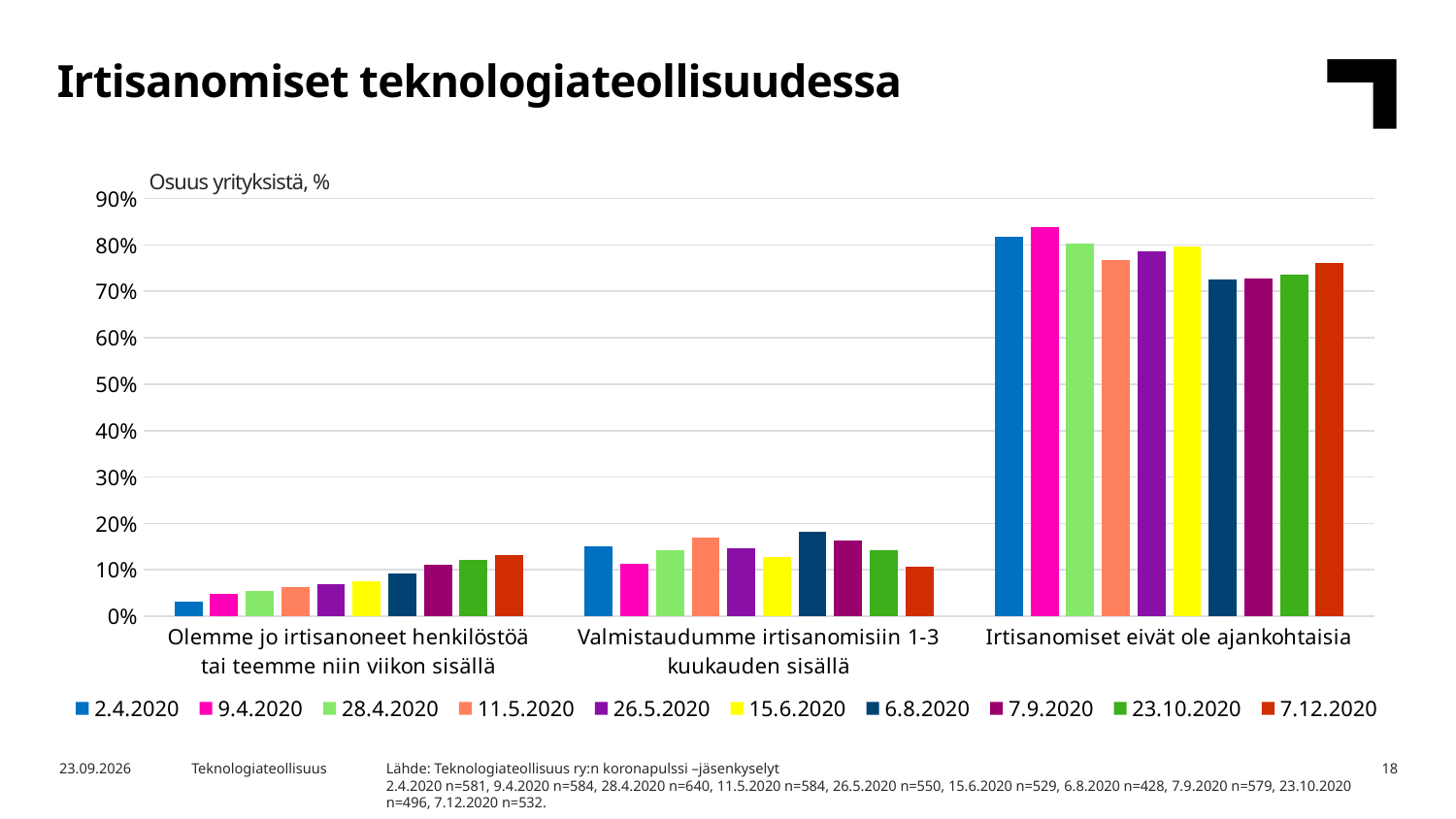
Is the value for 2.4.2020 in the category "Olemme jo irtisanoneet henkilöstöä tai teemme niin viikon sisällä" greater or less than 10%? less What kind of chart is shown on the slide? Bar chart Which survey date has the lowest value in the category "Olemme jo irtisanoneet henkilöstöä tai teemme niin viikon sisällä"? 2.4.2020 In the category "Olemme jo irtisanoneet henkilöstöä tai teemme niin viikon sisällä", do the values rise or fall from 2.4.2020 to 7.12.2020? rise Which survey date has the highest value in the category "Irtisanomiset eivät ole ajankohtaisia"? 9.4.2020 How many series does the legend list? 10 Is the value for 6.8.2020 in the category "Irtisanomiset eivät ole ajankohtaisia" greater or less than 80%? less In the category "Valmistaudumme irtisanomisiin 1-3 kuukauden sisällä", which is larger: the value for 6.8.2020 or for 9.4.2020? 6.8.2020 Is the value for 9.4.2020 in the category "Irtisanomiset eivät ole ajankohtaisia" greater or less than 80%? greater How many categories are shown on the x axis of the chart? 3 What is the label shown above the vertical axis of the chart? Osuus yrityksistä, %